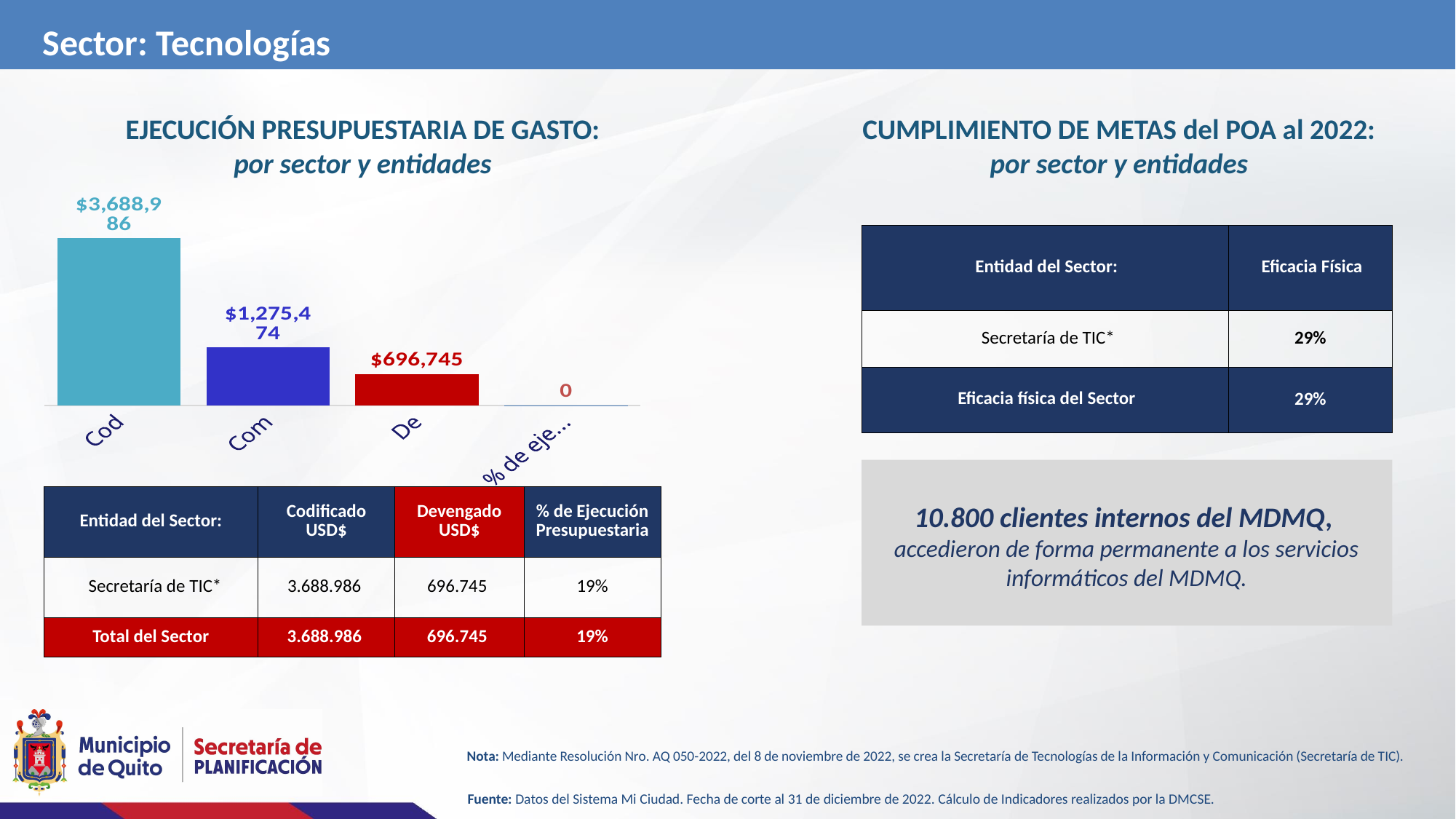
How many categories are shown on the x axis of the chart? 4 Do the values in the chart rise or fall from left to right along the x axis? Fall Which is larger in the chart, the Com value or the De value? Com What kind of chart is shown on the slide? Bar chart What is the difference between the Cod and De values in the chart? $2,992,241 What is the value of the Com bar in the chart? $1,275,474 What value is labelled for the '% de eje…' category in the chart? 0 Which category has the lowest value in the chart? % de eje… What is the difference between the Cod and Com values in the chart? $2,413,512 Which category has the highest bar in the chart? Cod What is the value of the De bar in the chart? $696,745 What is the value of the Cod bar in the chart? $3,688,986